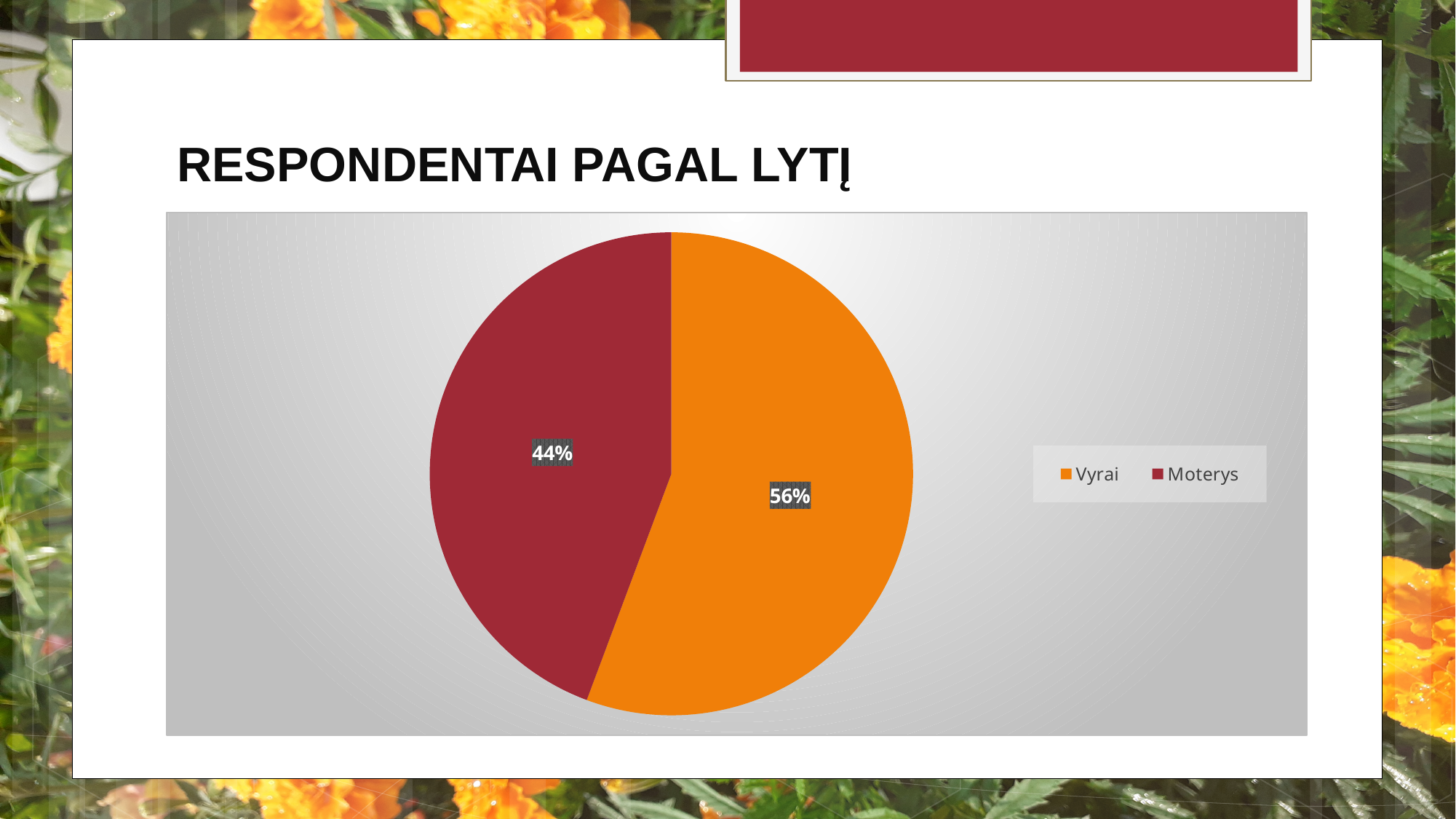
What is the difference in percentage points between the Vyrai and Moterys slices? 12% What is the title of the slide above the chart? RESPONDENTAI PAGAL LYTĮ How many slices does the pie chart have? 2 What colour is the Moterys slice? Dark red Which category has the smallest slice of the pie? Moterys How many entries does the legend list? 2 Which slice is larger, Vyrai or Moterys? Vyrai What share of the pie does Moterys represent? 44% Is the share for Vyrai greater or less than 50%? greater Which category has the largest slice of the pie? Vyrai What share of the pie does Vyrai represent? 56% What kind of chart is shown on the slide? Pie chart